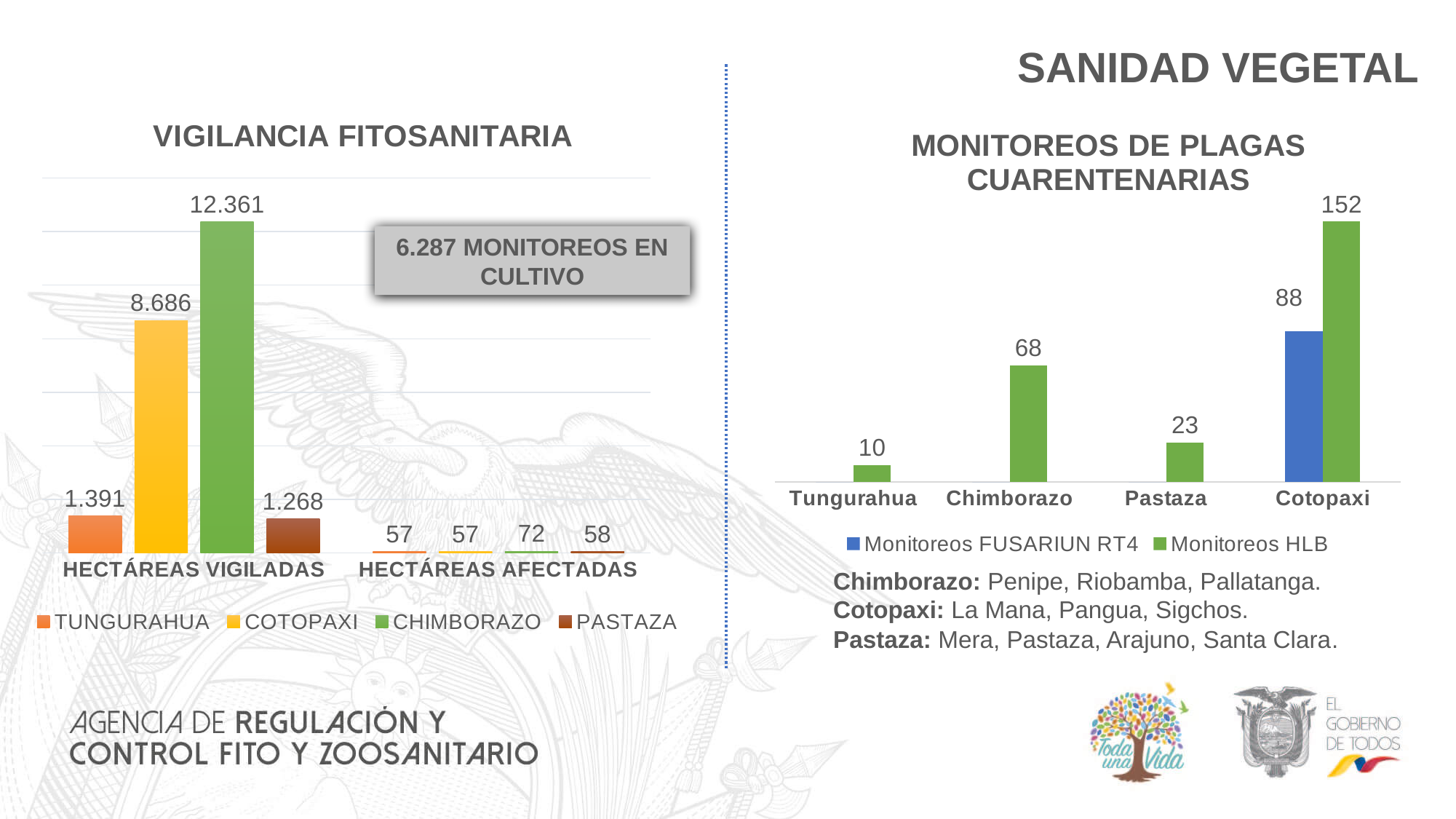
How many series does the legend of the VIGILANCIA FITOSANITARIA chart list? 4 In the VIGILANCIA FITOSANITARIA chart, which province has the lowest value for HECTÁREAS VIGILADAS? PASTAZA In the VIGILANCIA FITOSANITARIA chart, what is the value for PASTAZA under HECTÁREAS AFECTADAS? 58 In the VIGILANCIA FITOSANITARIA chart, which province has the highest value for HECTÁREAS VIGILADAS? CHIMBORAZO In the MONITOREOS DE PLAGAS CUARENTENARIAS chart, what is the value of Monitoreos HLB for Chimborazo? 68 In the MONITOREOS DE PLAGAS CUARENTENARIAS chart, which province has the highest value of Monitoreos HLB? Cotopaxi In the VIGILANCIA FITOSANITARIA chart, what is the difference between CHIMBORAZO and TUNGURAHUA under HECTÁREAS AFECTADAS? 15 In the MONITOREOS DE PLAGAS CUARENTENARIAS chart, what is the value of Monitoreos FUSARIUN RT4 for Cotopaxi? 88 In the VIGILANCIA FITOSANITARIA chart, what is the value for CHIMBORAZO under HECTÁREAS VIGILADAS? 12.361 What kind of chart is the MONITOREOS DE PLAGAS CUARENTENARIAS chart? Bar chart In the MONITOREOS DE PLAGAS CUARENTENARIAS chart, which is larger: Monitoreos HLB for Chimborazo or for Pastaza? Chimborazo In the MONITOREOS DE PLAGAS CUARENTENARIAS chart, what is the difference between Monitoreos HLB and Monitoreos FUSARIUN RT4 for Cotopaxi? 64